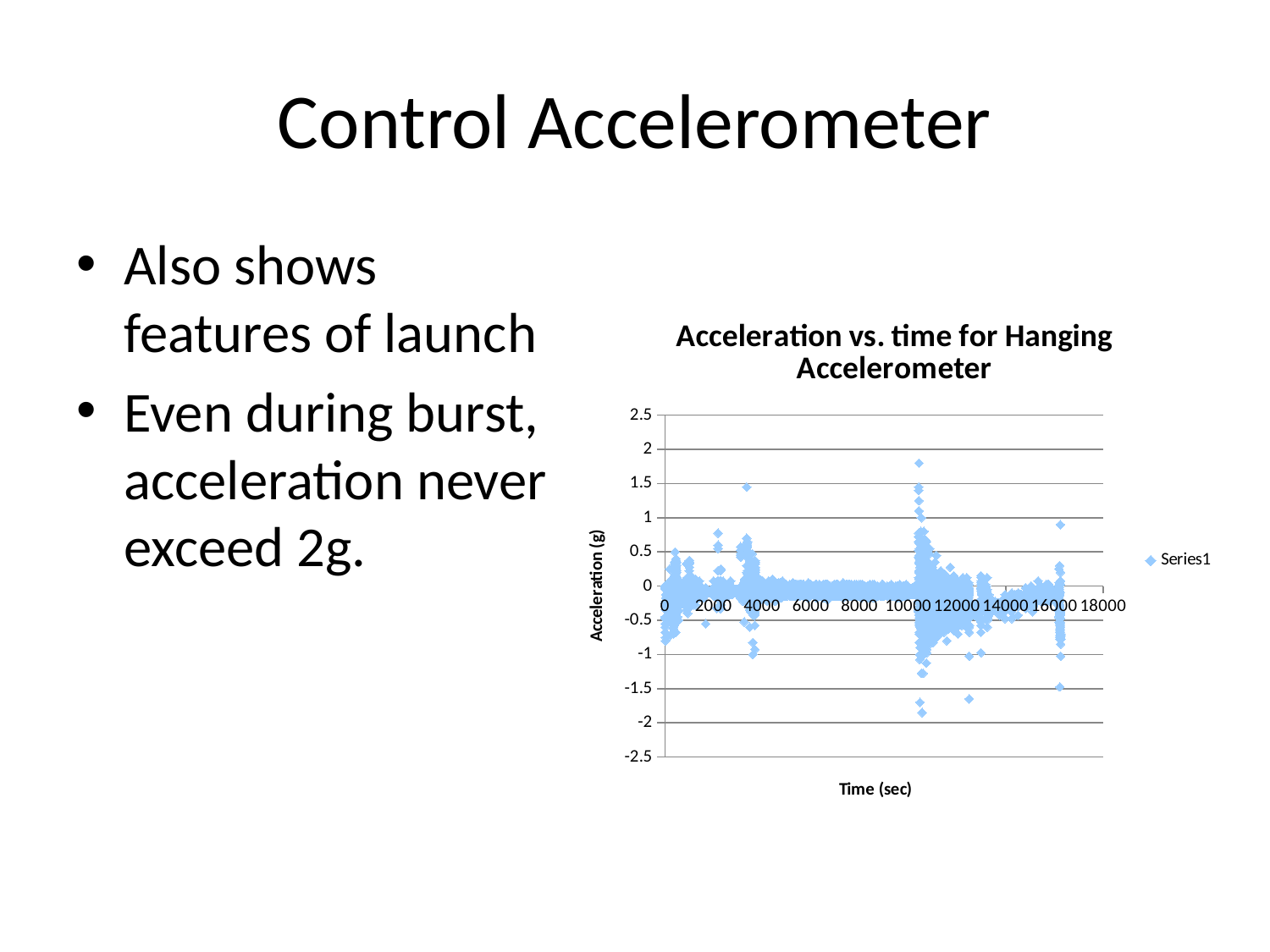
What is the maximum value shown on the vertical axis? 2.5 Is the highest plotted acceleration value greater or less than 2? less Is the lowest plotted acceleration value greater or less than -2? greater What kind of chart is shown on the slide? scatter chart What is the title of the chart? Acceleration vs. time for Hanging Accelerometer Is the lowest plotted acceleration value greater or less than -1.5? less What is the maximum value shown on the horizontal axis? 18000 How many series does the chart's legend list? 1